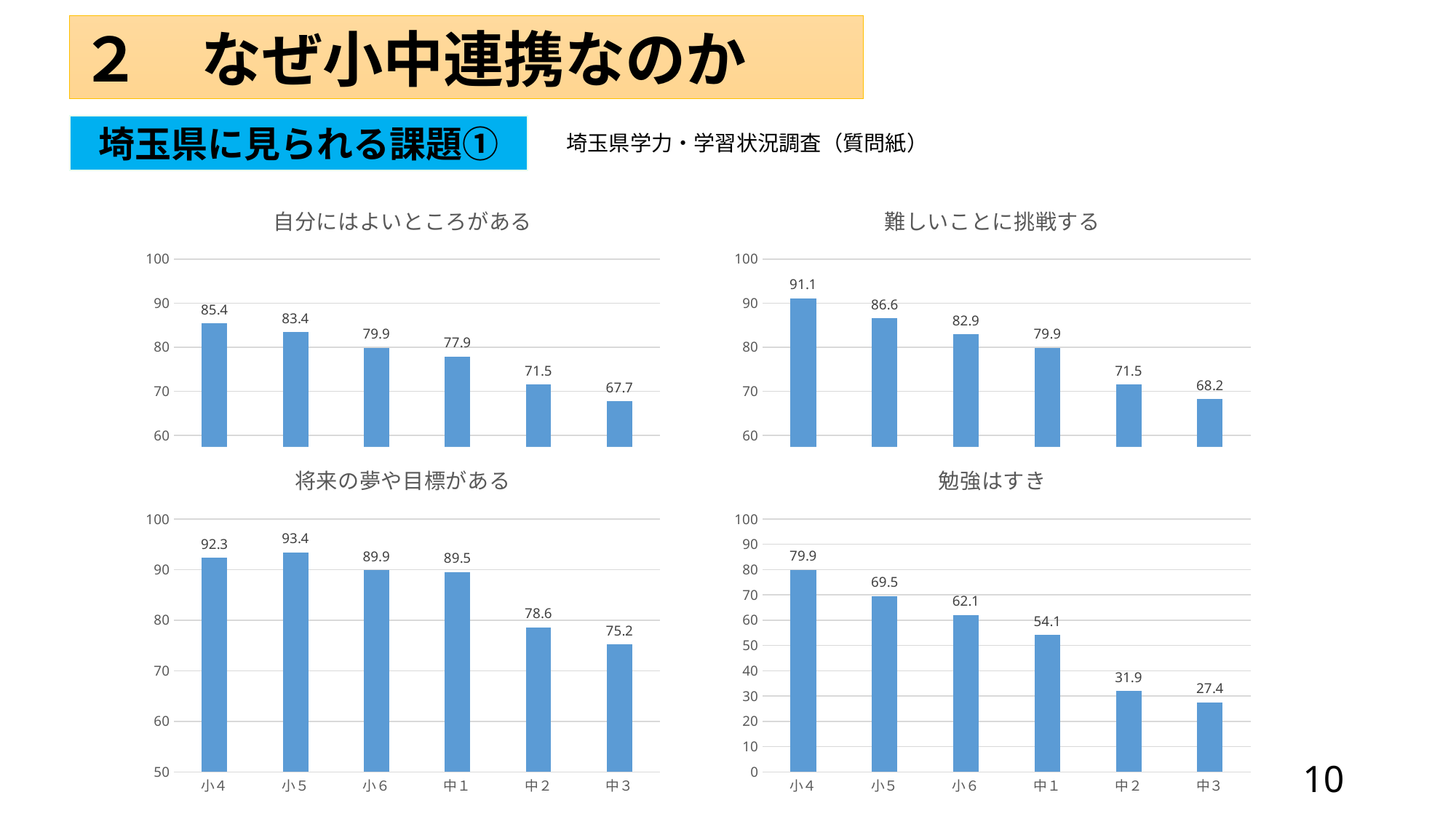
In the chart titled 自分にはよいところがある, is the value for 中２ greater or less than 70? greater In the chart titled 勉強はすき, what is the difference between the values for 小４ and 中３? 52.5 In the chart titled 将来の夢や目標がある, which is larger, the value for 中１ or the value for 中２? 中１ In the chart titled 自分にはよいところがある, what is the value for 小４? 85.4 In the chart titled 勉強はすき, which category has the lowest value? 中３ How many categories are shown on the x axis of the chart titled 勉強はすき? 6 In the chart titled 将来の夢や目標がある, which category has the highest value? 小５ In the chart titled 難しいことに挑戦する, what is the value for 中３? 68.2 How many charts are shown on the slide? 4 In the chart titled 難しいことに挑戦する, what is the difference between the values for 小４ and 小５? 4.5 What kind of chart is the chart titled 将来の夢や目標がある? bar chart In the chart titled 勉強はすき, do the values rise or fall from 小４ to 中３? fall